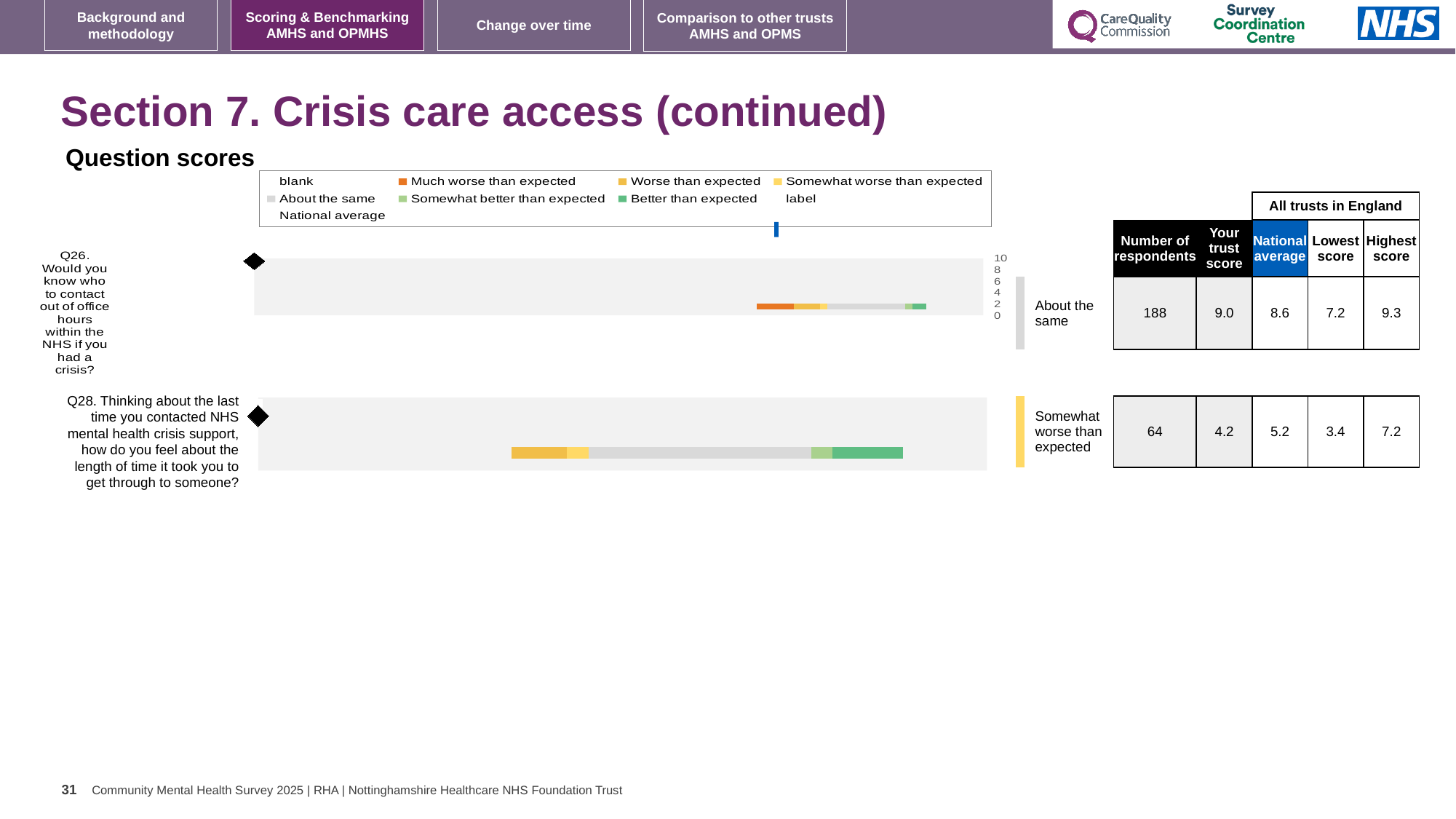
What kind of chart is used to show the question scores for Q26 and Q28? Bar chart What benchmark category is shown for Q28? Somewhat worse than expected Which question has the higher trust score, Q26 or Q28? Q26 How many questions are plotted in the question scores charts? 2 What is the 'Your trust score' value for Q26 (Would you know who to contact out of office hours within the NHS if you had a crisis?)? 9.0 For Q28, what is the difference between the national average (5.2) and the trust score (4.2)? 1.0 What is the national average score for Q26? 8.6 How many respondents answered Q28? 64 For Q26, which is larger: the trust score or the national average? Your trust score What is the highest score among all trusts in England for Q28? 7.2 What benchmark category is shown for Q26? About the same What is the 'Your trust score' value for Q28 (length of time it took to get through to someone)? 4.2